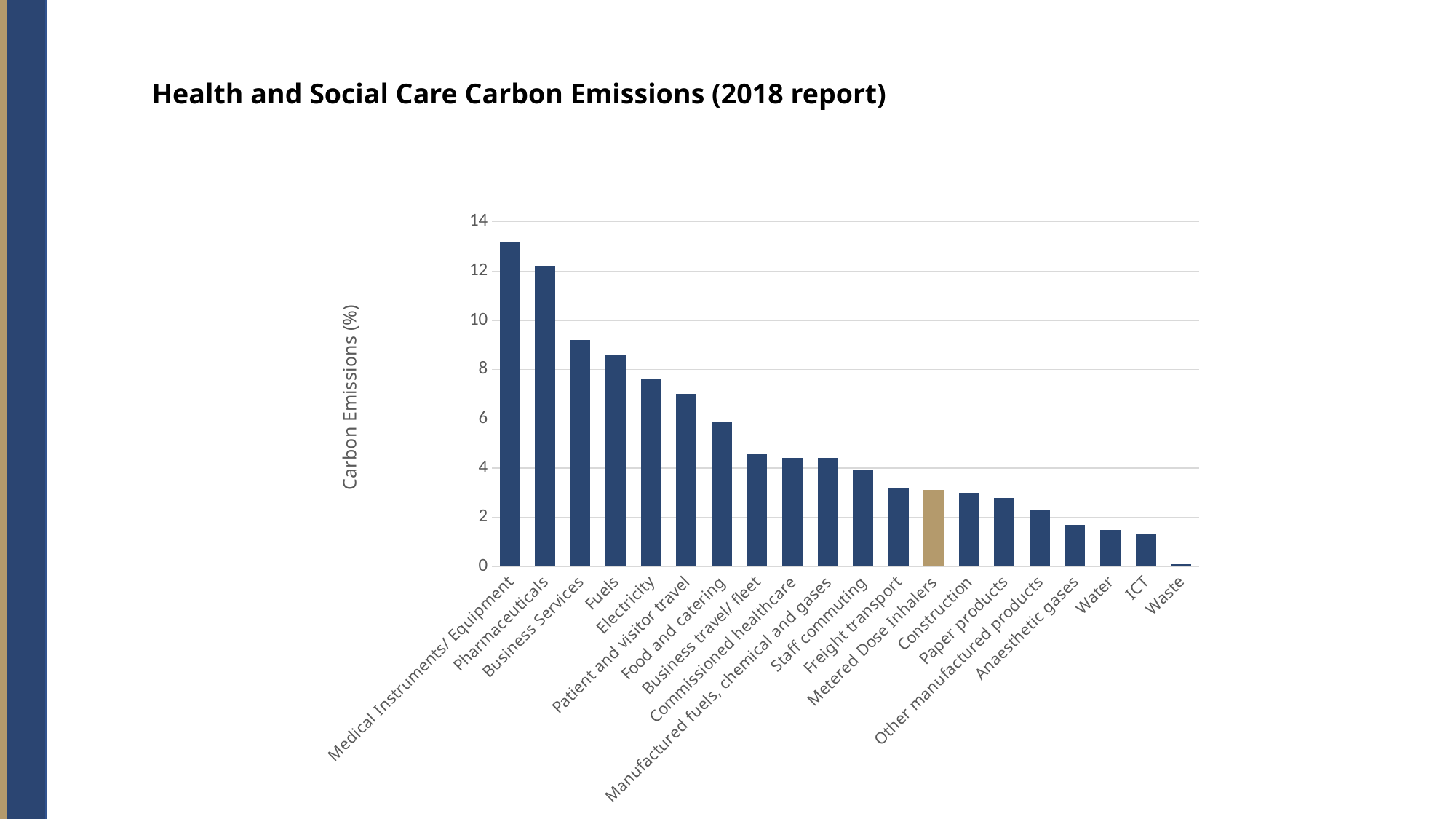
Which category's bar is shown in a different colour (gold) from the rest? Metered Dose Inhalers Which category has the highest carbon emissions share? Medical Instruments/ Equipment Which is larger, the value for Pharmaceuticals or the value for Business Services? Pharmaceuticals What is the label on the vertical axis? Carbon Emissions (%) Which category has the lowest carbon emissions share? Waste Is the value for Pharmaceuticals greater or less than 12? greater Do the values rise or fall moving from left to right along the x axis? Fall Is the value for Business Services greater or less than 10? less Is the value for Anaesthetic gases greater or less than 2? less What kind of chart is shown on the slide? Bar chart How many categories are plotted on the chart? 20